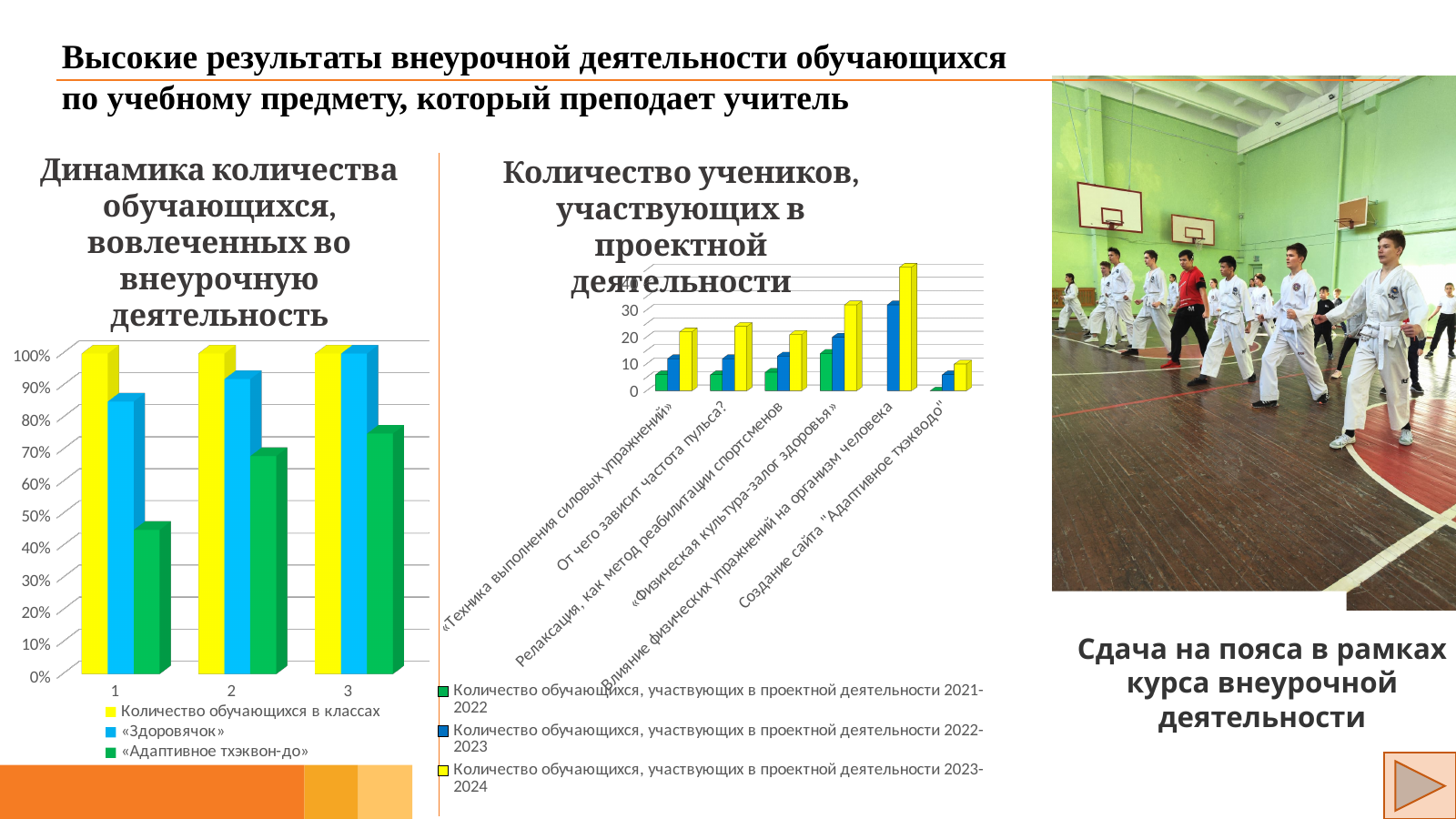
What colour represents «Здоровячок» in the left chart «Динамика количества обучающихся, вовлеченных во внеурочную деятельность»? Blue How many categories are shown on the x axis of the left chart «Динамика количества обучающихся, вовлеченных во внеурочную деятельность»? 3 How many series does the legend of the middle chart «Количество учеников, участвующих в проектной деятельности» list? 3 What kind of chart is the left chart titled «Динамика количества обучающихся, вовлеченных во внеурочную деятельность»? Bar chart How many series does the legend of the left chart «Динамика количества обучающихся, вовлеченных во внеурочную деятельность» list? 3 What kind of chart is the middle chart titled «Количество учеников, участвующих в проектной деятельности»? Bar chart In the left chart «Динамика количества обучающихся, вовлеченных во внеурочную деятельность», is the value of «Адаптивное тхэквон-до» for category 1 greater or less than 50%? less How many categories are shown on the x axis of the middle chart «Количество учеников, участвующих в проектной деятельности»? 6 In the middle chart «Количество учеников, участвующих в проектной деятельности», which category has the highest value for 2023-2024? Влияние физических упражнений на организм человека In the left chart «Динамика количества обучающихся, вовлеченных во внеурочную деятельность», do the values of «Адаптивное тхэквон-до» rise or fall from category 1 to category 3? rise In the left chart «Динамика количества обучающихся, вовлеченных во внеурочную деятельность», for category 2, which is larger: «Здоровячок» or «Адаптивное тхэквон-до»? «Здоровячок» In the left chart «Динамика количества обучающихся, вовлеченных во внеурочную деятельность», is the value of «Здоровячок» for category 1 greater or less than 80%? greater